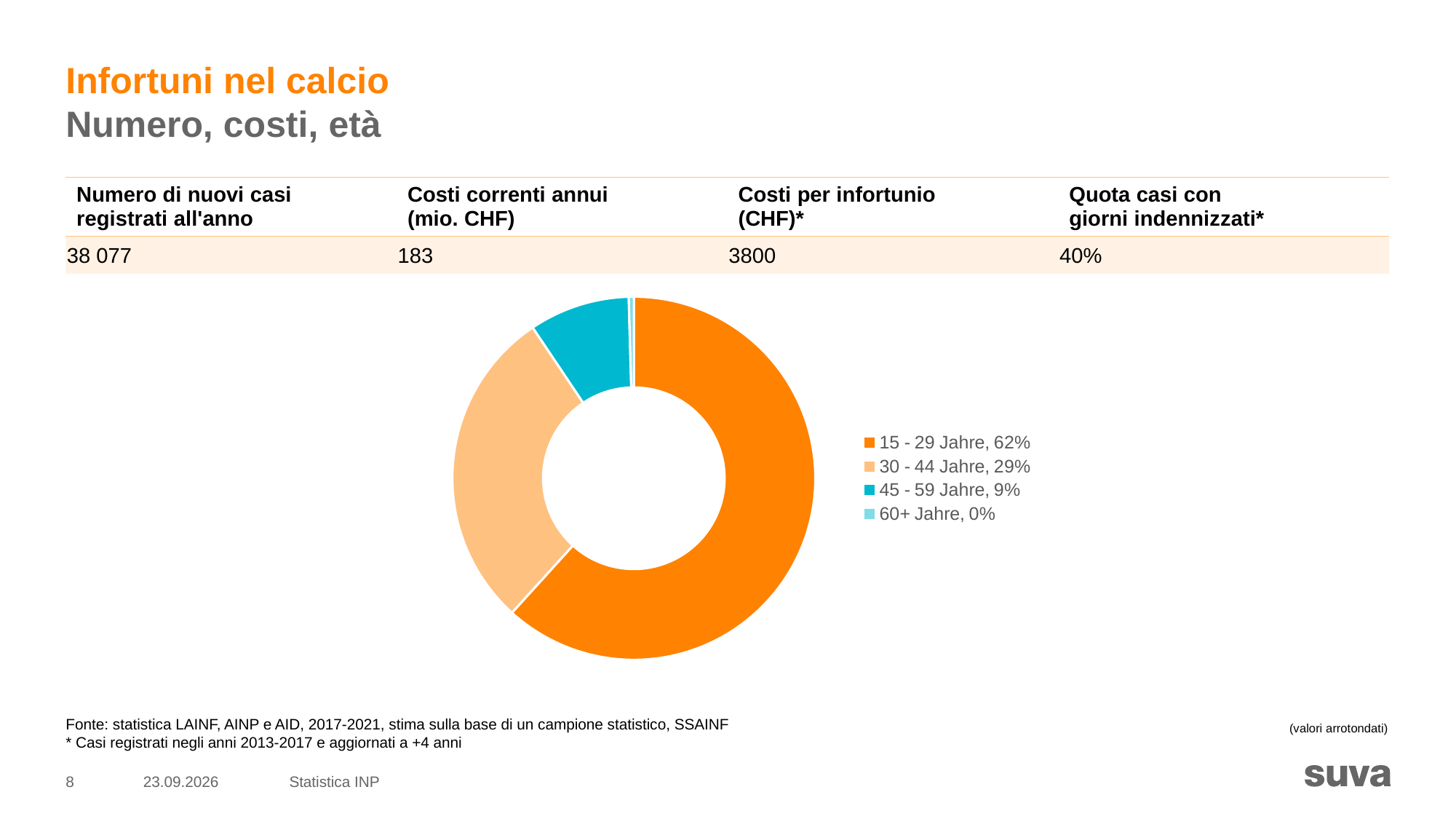
What is the value shown for 60+ Jahre in the donut chart? 0% What kind of chart is shown on the slide? Donut (pie) chart Which age group has the smallest slice in the donut chart? 60+ Jahre What colour is the 45 - 59 Jahre slice in the donut chart? Teal/cyan What is the combined share of the 15 - 29 Jahre and 30 - 44 Jahre slices? 91% What share of the donut chart does the 30 - 44 Jahre slice represent? 29% What is the value shown for 45 - 59 Jahre in the donut chart? 9% Which age group has the largest slice in the donut chart? 15 - 29 Jahre What share of the donut chart does the 15 - 29 Jahre slice represent? 62% What is the difference in percentage points between the 15 - 29 Jahre and 30 - 44 Jahre slices? 33 How many age groups are listed in the legend of the donut chart? 4 Which slice is larger in the donut chart: 30 - 44 Jahre or 45 - 59 Jahre? 30 - 44 Jahre